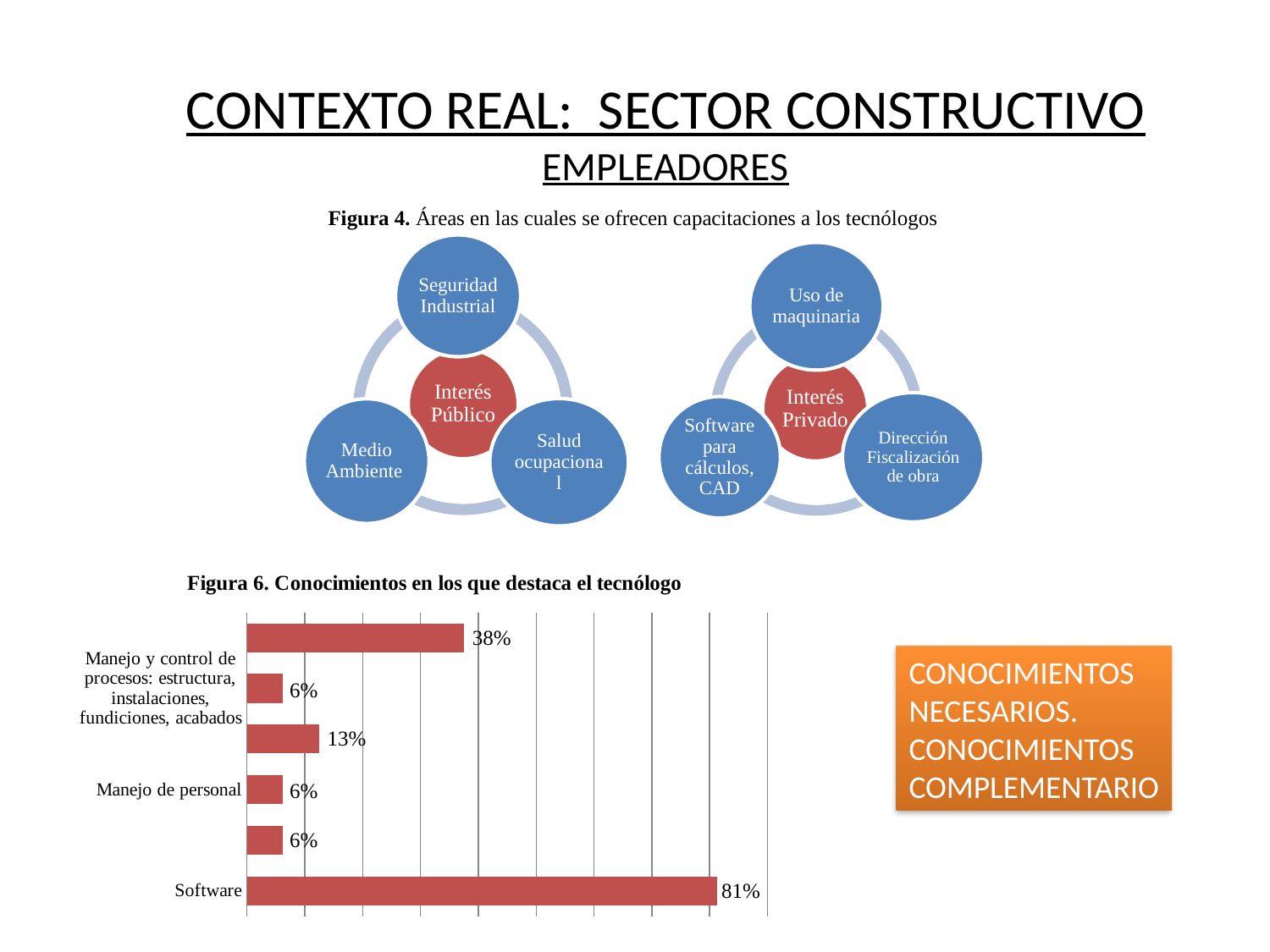
What kind of chart is Figura 6? Bar chart In Figura 6, what is the value for Manejo de personal? 6% In Figura 6, what is the value shown on the topmost bar? 38% What is the title of the bar chart on the slide? Figura 6. Conocimientos en los que destaca el tecnólogo In Figura 6, what is the difference between the value for Software and the value on the topmost bar? 43% In Figura 6, how many bars are plotted? 6 In Figura 6, what is the value of the third bar from the top? 13% In Figura 6, which is larger: the value for Software or the value for Manejo de personal? Software In Figura 6, what is the difference between the value for Software and the value for Manejo de personal? 75% In Figura 6, how many bars show a value of 6%? 3 In Figura 6, what is the value for Software? 81% In Figura 6, which category has the highest value? Software